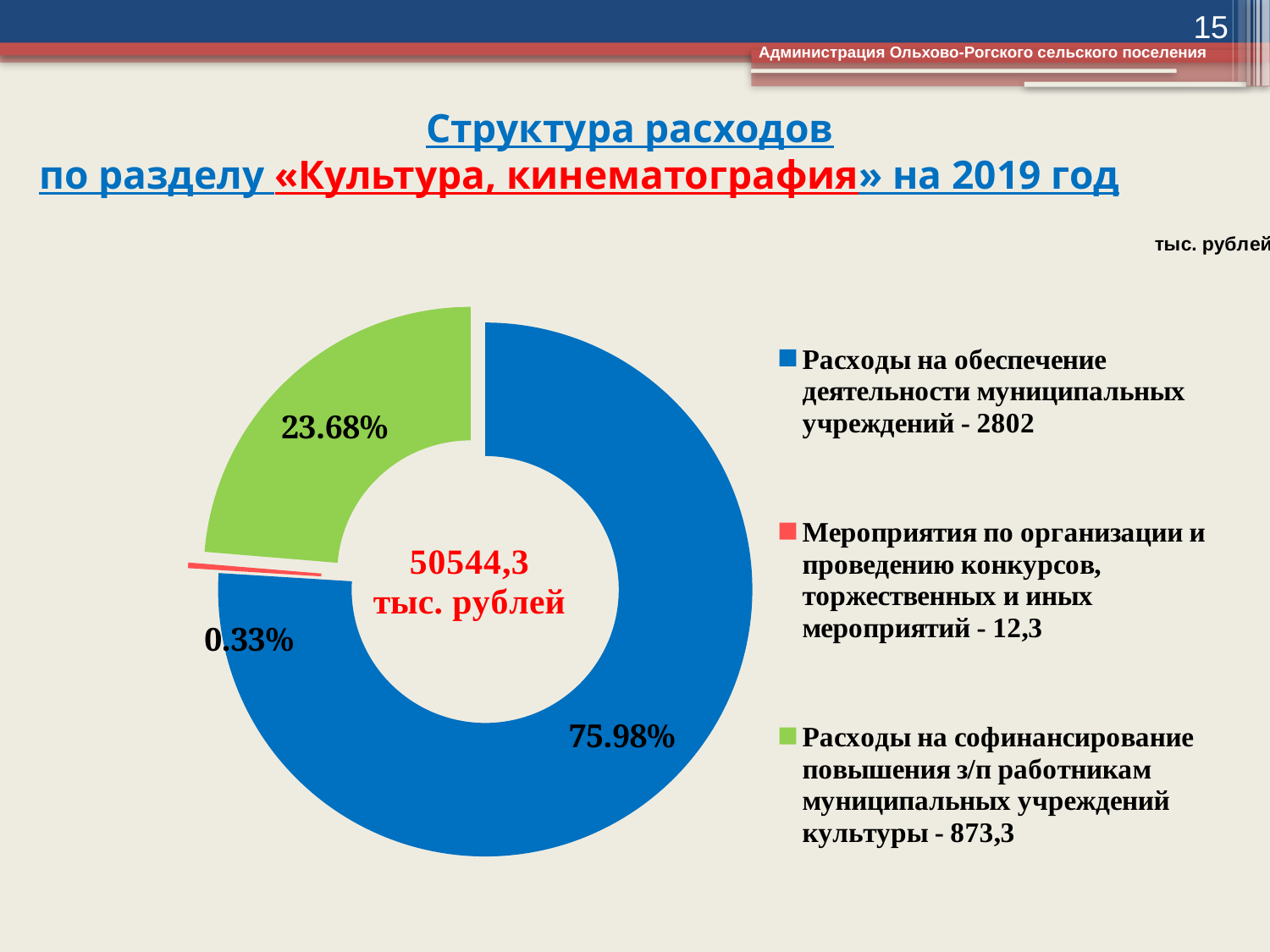
What value (тыс. рублей) does the legend give for «Мероприятия по организации и проведению конкурсов, торжественных и иных мероприятий»? 12,3 What share of the chart is labelled for «Расходы на софинансирование повышения з/п работникам муниципальных учреждений культуры»? 23.68% What value (тыс. рублей) does the legend give for «Расходы на обеспечение деятельности муниципальных учреждений»? 2802 What share of the chart is labelled for «Расходы на обеспечение деятельности муниципальных учреждений»? 75.98% What share of the chart is labelled for «Мероприятия по организации и проведению конкурсов, торжественных и иных мероприятий»? 0.33% Which category has the smallest share of the chart? Мероприятия по организации и проведению конкурсов, торжественных и иных мероприятий What kind of chart is shown on the slide? Doughnut (pie) chart How many entries does the legend list? 3 What text is shown in the centre of the doughnut chart? 50544,3 тыс. рублей What value (тыс. рублей) does the legend give for «Расходы на софинансирование повышения з/п работникам муниципальных учреждений культуры»? 873,3 How many slices does the chart have? 3 Which category has the largest share of the chart? Расходы на обеспечение деятельности муниципальных учреждений